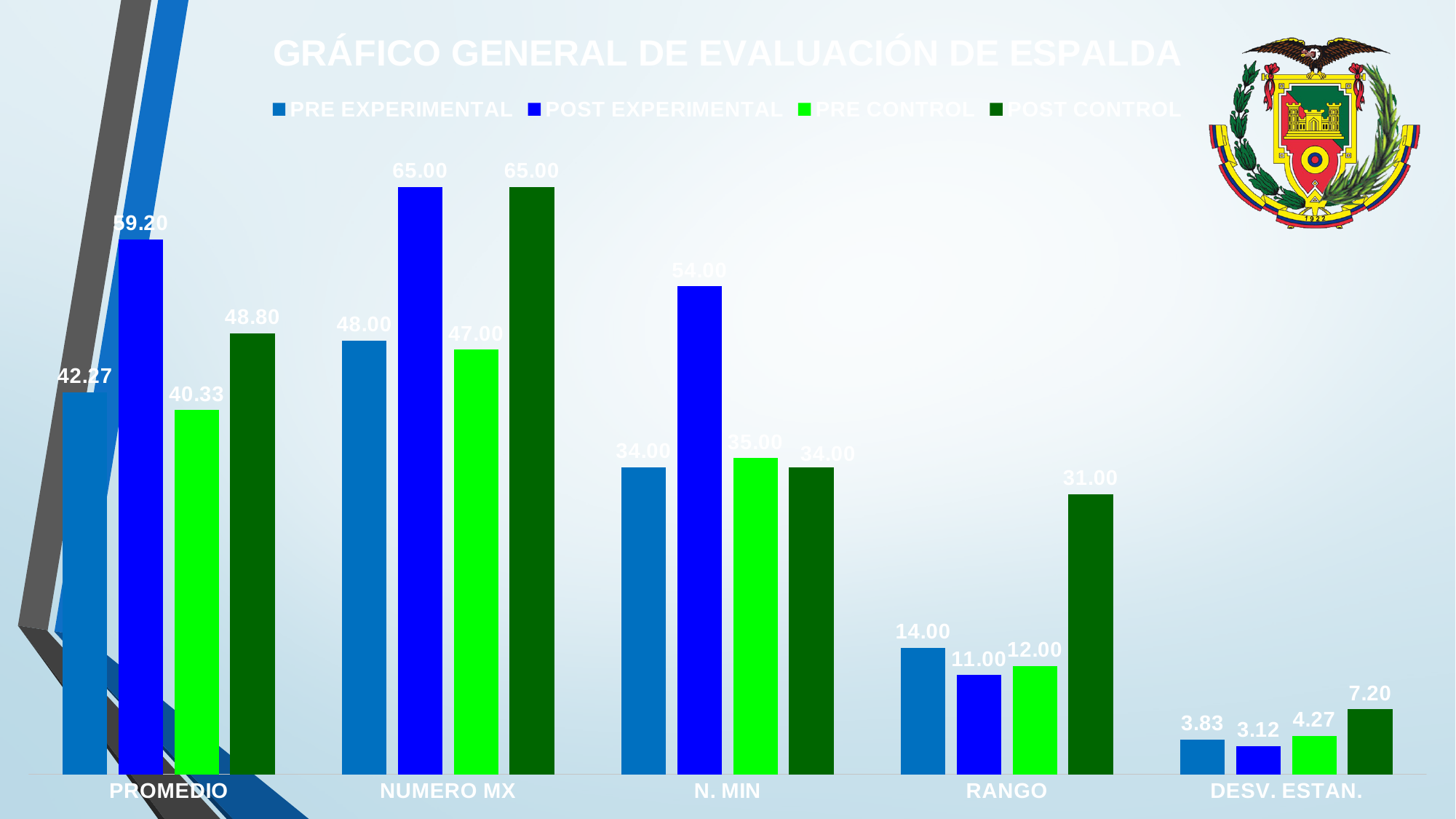
Which series has the highest value for N. MIN? POST EXPERIMENTAL Which is larger for DESV. ESTAN., PRE CONTROL or POST CONTROL? POST CONTROL What type of chart is shown on the slide? Bar chart What is the value of POST CONTROL for RANGO? 31.00 Which series has the lowest value for PROMEDIO? PRE CONTROL What is the value of PRE CONTROL for NUMERO MX? 47.00 What is the value of PRE EXPERIMENTAL for DESV. ESTAN.? 3.83 What is the difference between POST EXPERIMENTAL and PRE EXPERIMENTAL for PROMEDIO? 16.93 How many categories are shown on the x axis? 5 What is the difference between POST CONTROL and PRE CONTROL for RANGO? 19.00 How many series does the legend list? 4 What is the value of POST EXPERIMENTAL for PROMEDIO? 59.20